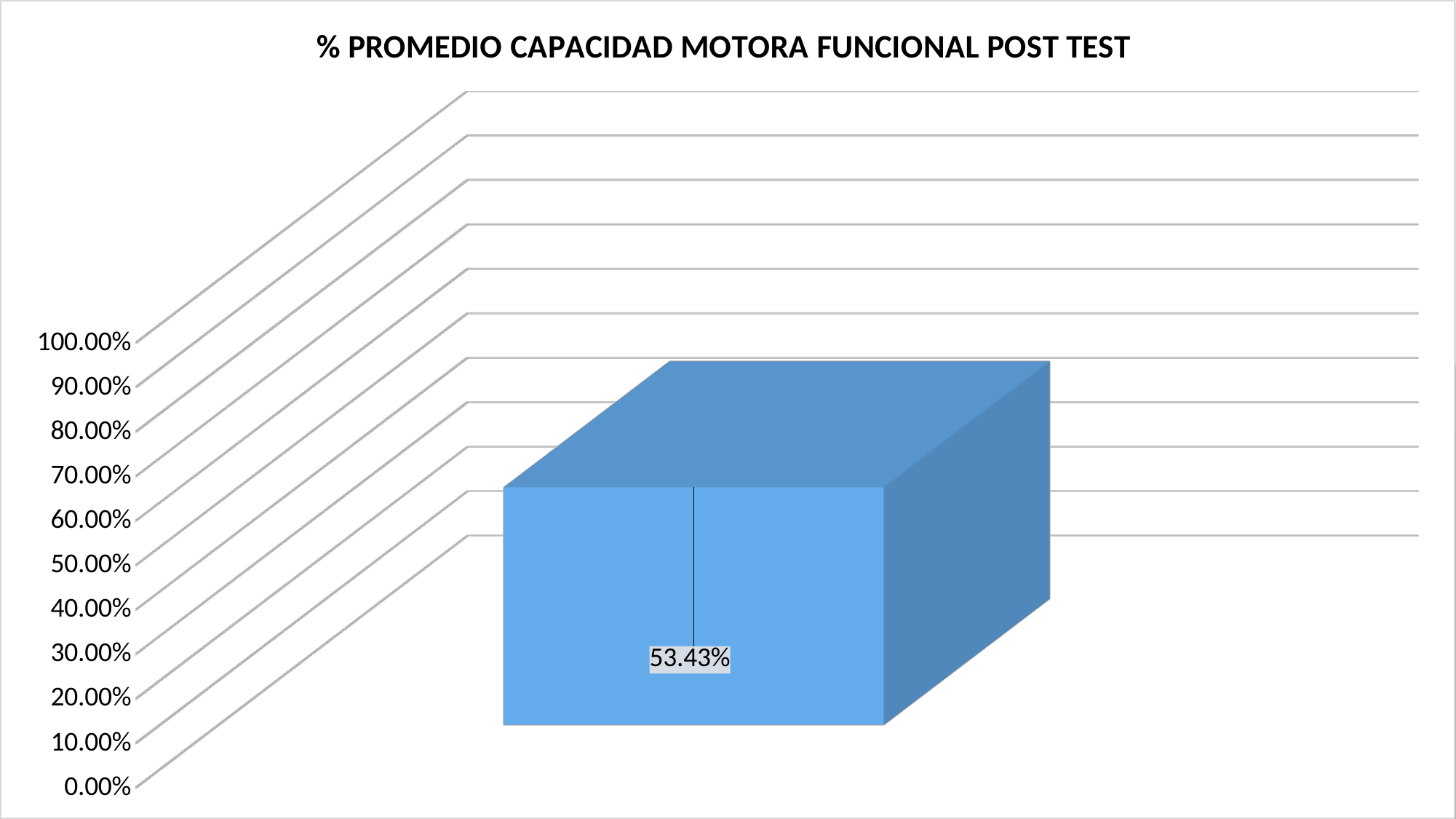
What is the title of the chart? % PROMEDIO CAPACIDAD MOTORA FUNCIONAL POST TEST Is the value of the bar greater or less than 50.00%? greater Is the value of the bar greater or less than 60.00%? less What is the highest tick label shown on the vertical axis? 100.00% How many bars are plotted in the chart? 1 Is the value of the bar greater or less than 100.00%? less What value is printed on the bar in the chart? 53.43% What kind of chart is shown on the slide? bar chart